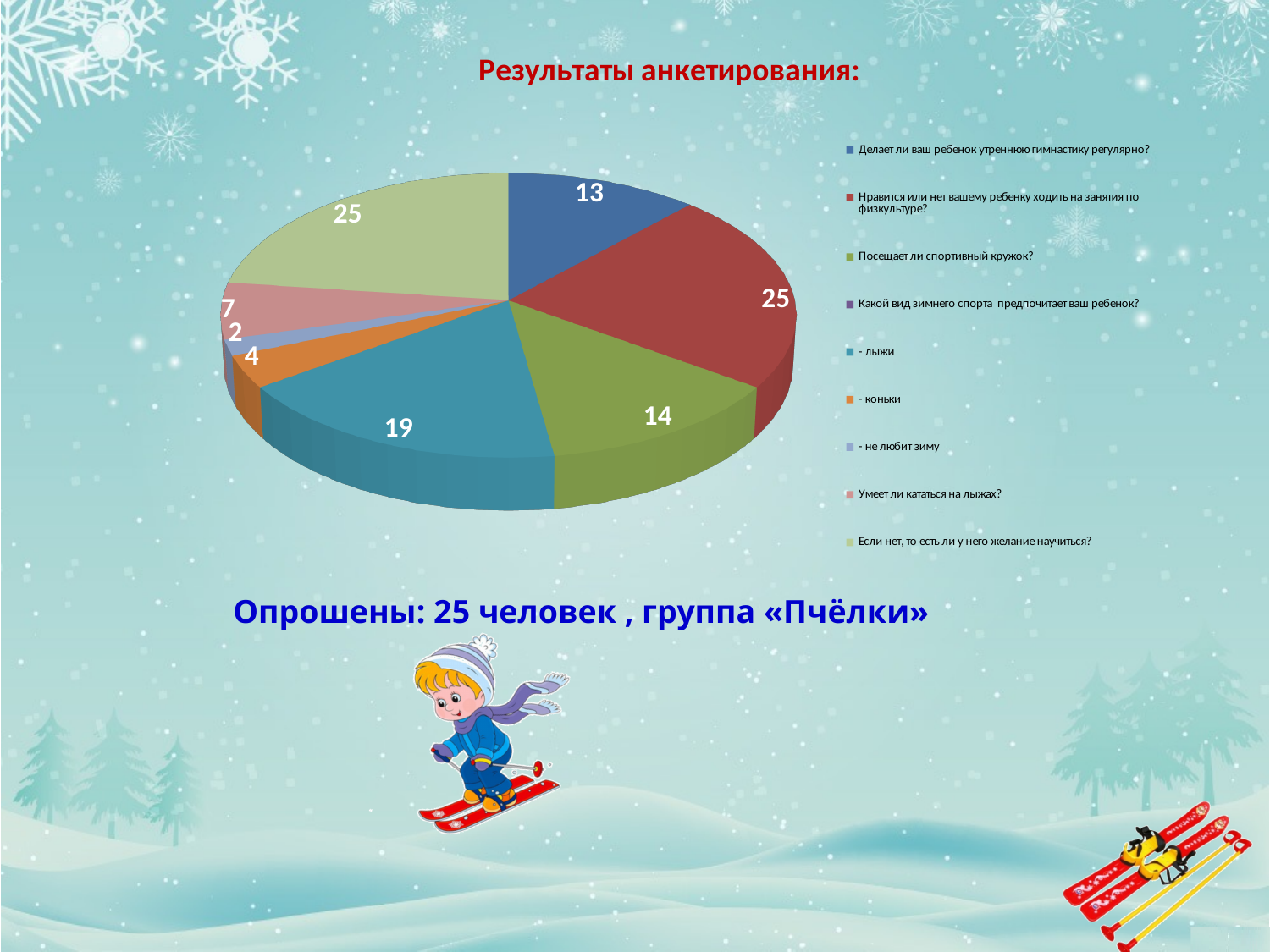
What value is shown for the slice "Делает ли ваш ребенок утреннюю гимнастику регулярно?"? 13 What value is shown for the slice "- лыжи"? 19 According to the text below the chart, how many people were surveyed? 25 What value is shown for the slice "Умеет ли кататься на лыжах?"? 7 What value is shown for the slice "Посещает ли спортивный кружок?"? 14 Which is larger: the value for "- лыжи" or the value for "- коньки"? - лыжи What is the title of the chart on the slide? Результаты анкетирования: What is the difference between the value for "Нравится или нет вашему ребенку ходить на занятия по физкультуре?" and the value for "Делает ли ваш ребенок утреннюю гимнастику регулярно?"? 12 How many entries does the chart legend list? 9 Which slice has the smallest labelled value in the pie chart? - не любит зиму What value is shown for the slice "- коньки"? 4 What kind of chart is shown on the slide? Pie chart